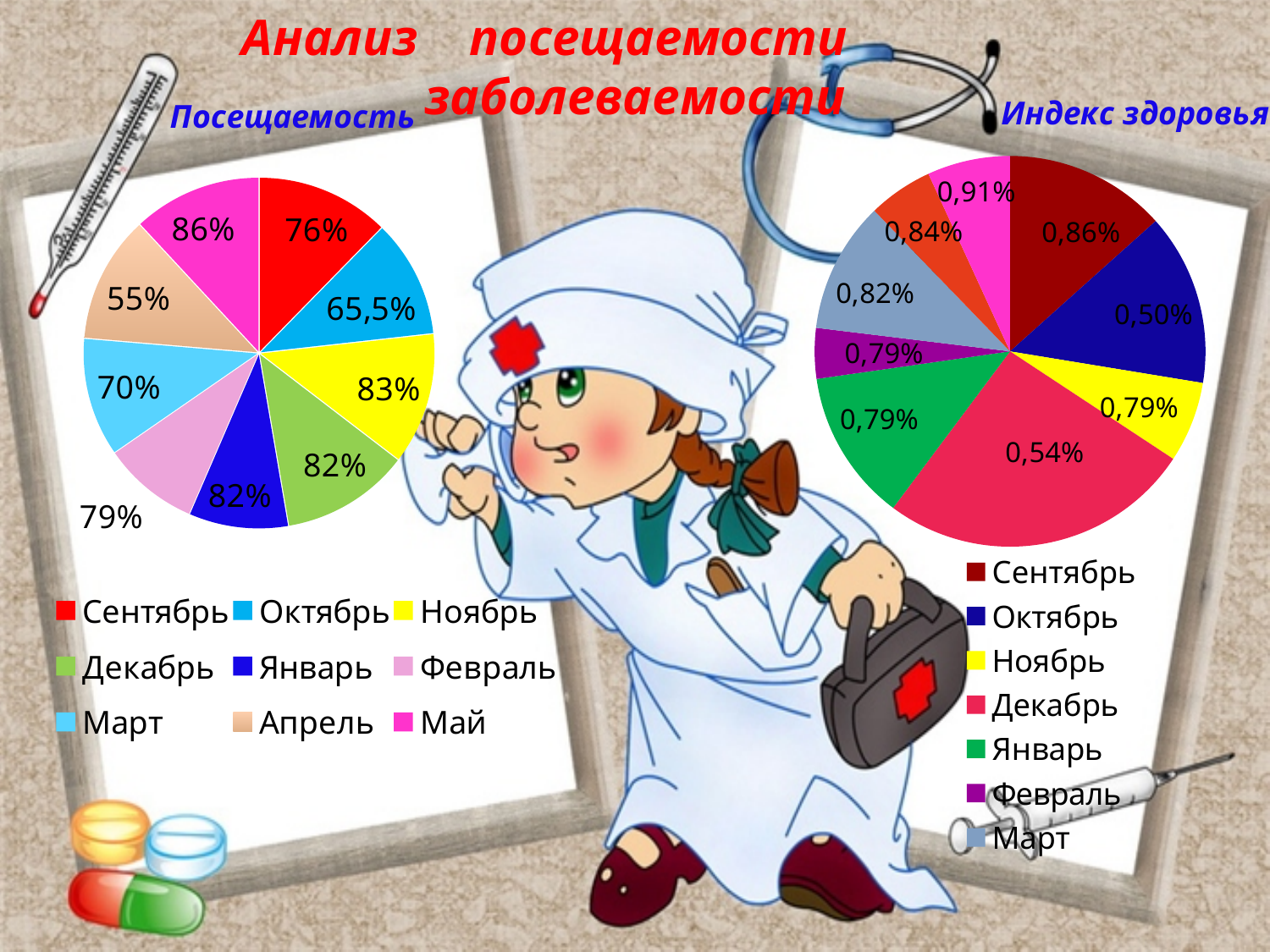
In the "Индекс здоровья" chart, which month has the lowest value? Октябрь What kind of chart is the "Посещаемость" chart? pie chart In the "Индекс здоровья" chart, what is the value for Октябрь? 0,50% How many slices does the "Посещаемость" pie chart have? 9 How many entries does the legend of the "Индекс здоровья" chart list? 7 In the "Посещаемость" chart, which month has the lowest value? Апрель In the "Посещаемость" chart, what is the difference between the values for Май and Апрель? 31% In the "Посещаемость" chart, which is larger, the value for Сентябрь or the value for Март? Сентябрь In the "Посещаемость" chart, which month has the highest value? Май In the "Посещаемость" chart, what is the value for Апрель? 55% In the "Посещаемость" chart, what is the value for Октябрь? 65,5% In the "Индекс здоровья" chart, what is the value for Сентябрь? 0,86%